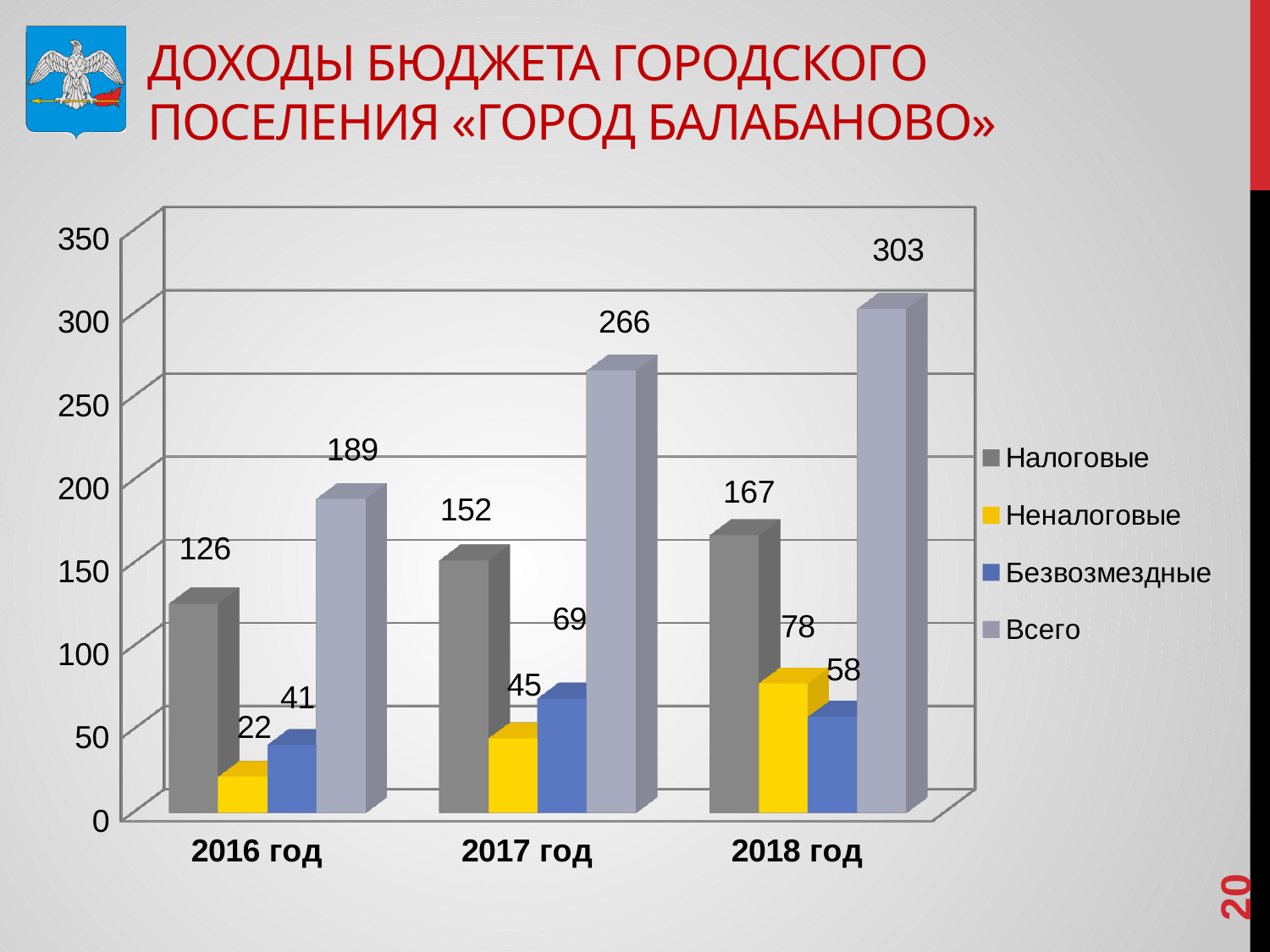
What is the value of Всего for 2018 год? 303 In which year is Неналоговые the lowest? 2016 год Which is larger: Безвозмездные for 2017 год or Безвозмездные for 2018 год? Безвозмездные for 2017 год What kind of chart is shown on the slide? bar chart How many years are shown on the x axis? 3 What is the value of Неналоговые for 2017 год? 45 What is the value of Налоговые for 2016 год? 126 What is the difference between Всего for 2018 год and Всего for 2017 год? 37 In which year is Всего the highest? 2018 год Does the value of Налоговые rise or fall from 2016 год to 2018 год? rise What is the value of Безвозмездные for 2018 год? 58 How many series does the legend list? 4